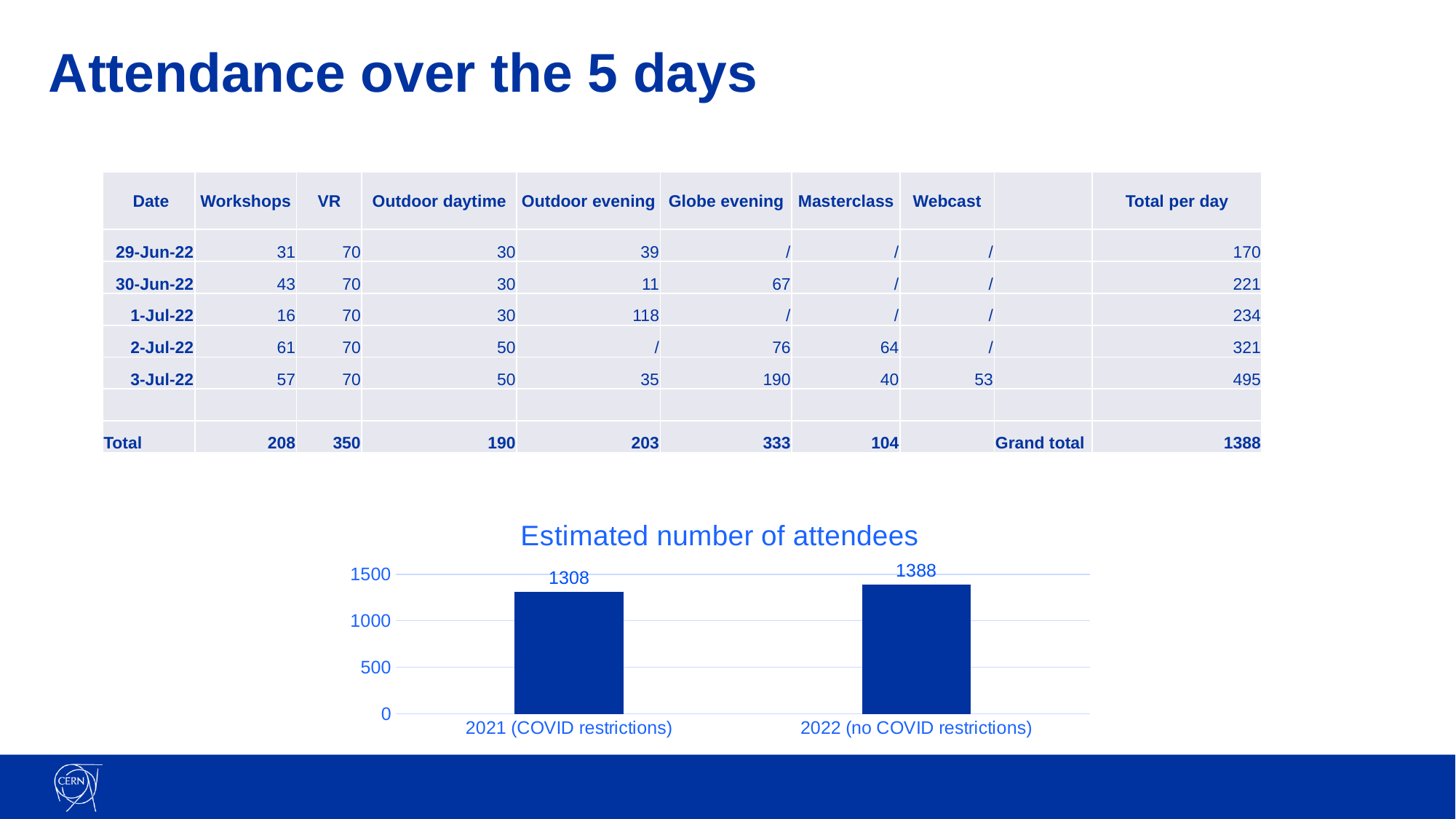
Do the values rise or fall from 2021 to 2022? Rise What is the estimated number of attendees for 2021 (COVID restrictions)? 1308 Which year has the lower estimated number of attendees? 2021 (COVID restrictions) Is the estimated number of attendees for 2021 greater or less than 1000? greater Which year has the higher estimated number of attendees? 2022 (no COVID restrictions) How many categories are shown in the chart? 2 What kind of chart is shown on the slide? Bar chart What is the title of the chart? Estimated number of attendees Is the estimated number of attendees for 2022 greater or less than 1500? less What is the highest value shown on the chart's y axis? 1500 What is the estimated number of attendees for 2022 (no COVID restrictions)? 1388 What is the difference in estimated attendees between 2022 and 2021? 80